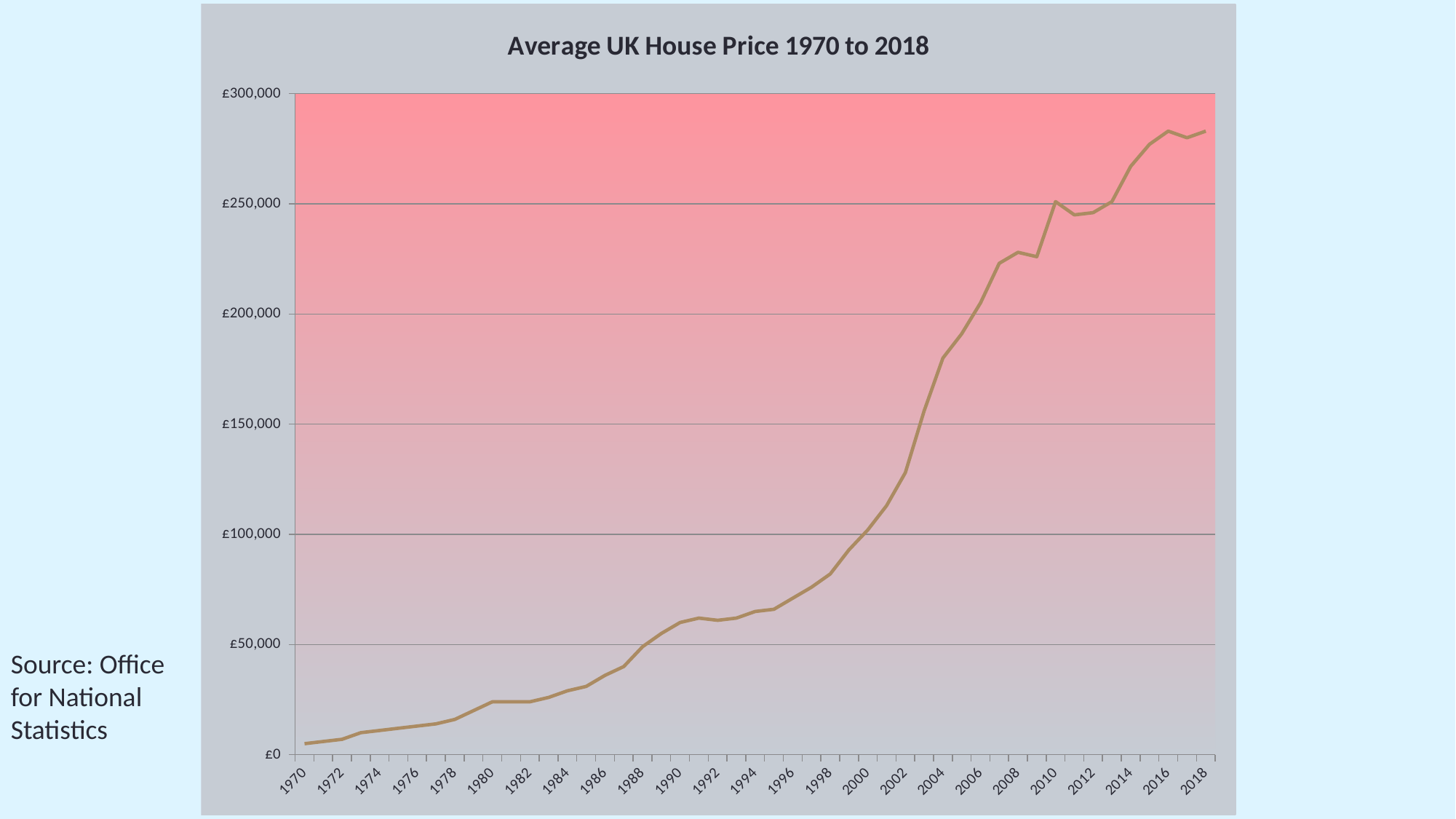
What kind of chart is shown on the slide? Line chart What is the title of the chart? Average UK House Price 1970 to 2018 Is the average house price for 2008 greater or less than £250,000? less Is the average house price for 2002 greater or less than £100,000? greater Is the average house price for 2018 greater or less than £250,000? greater Which year has the higher average house price, 1990 or 2004? 2004 What is the highest value shown on the vertical axis? £300,000 Overall, does the average UK house price rise or fall from 1970 to 2018? Rise Which year has the lowest average UK house price on the chart? 1970